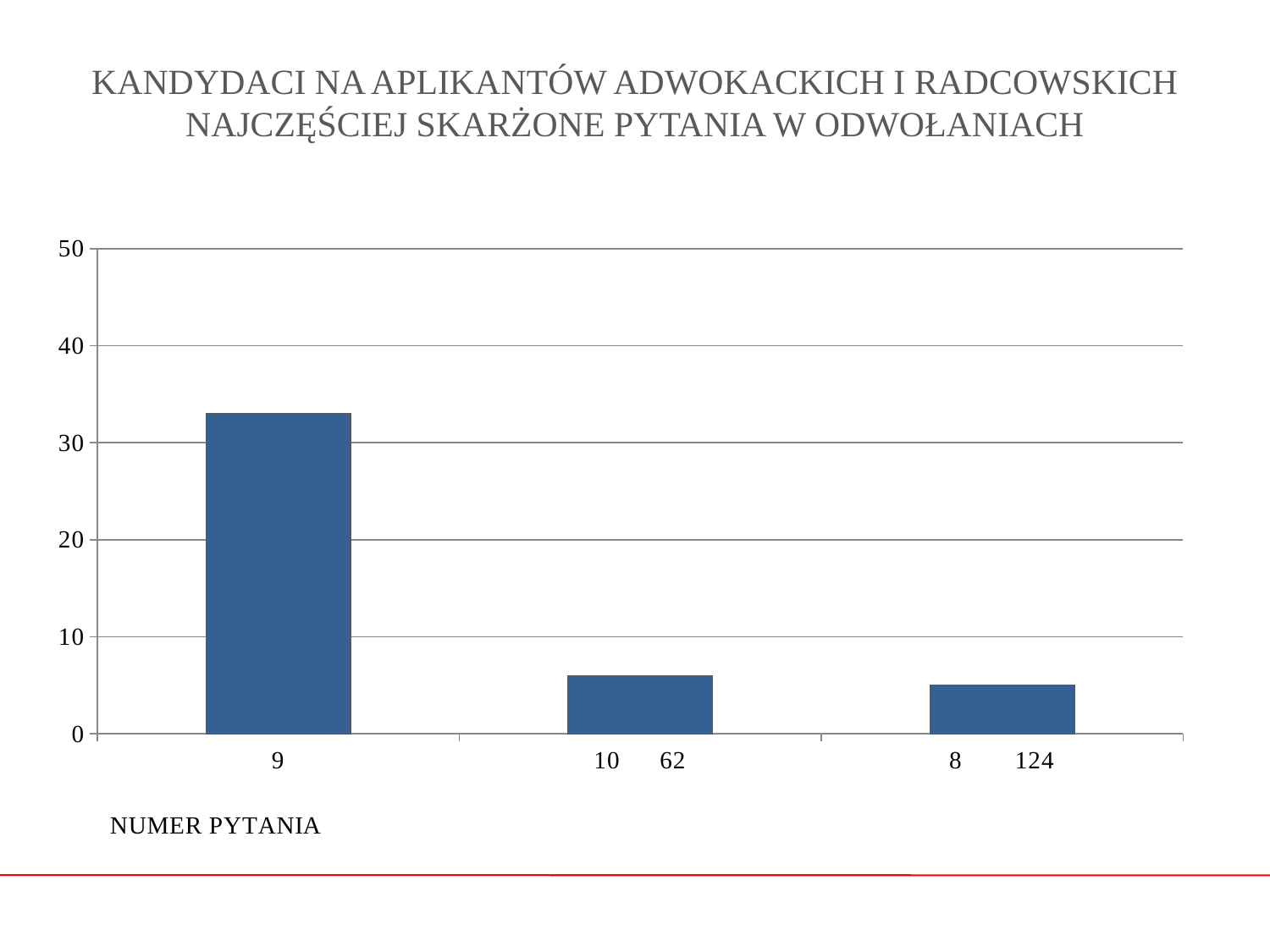
Is the value for category 9 greater or less than 40? less What is the highest value shown on the y axis of the chart? 50 What is the label shown below the x axis of the chart? NUMER PYTANIA Which category has the lowest bar? 8 124 Which is larger, the value for category 9 or the value for category 10 62? 9 Which category has the highest bar? 9 Which is larger, the value for category 8 124 or the value for category 9? 9 Is the value for category 9 greater or less than 30? greater What kind of chart is shown on the slide? bar chart How many bars are plotted in the chart? 3 Is the value for category 10 62 greater or less than 10? less